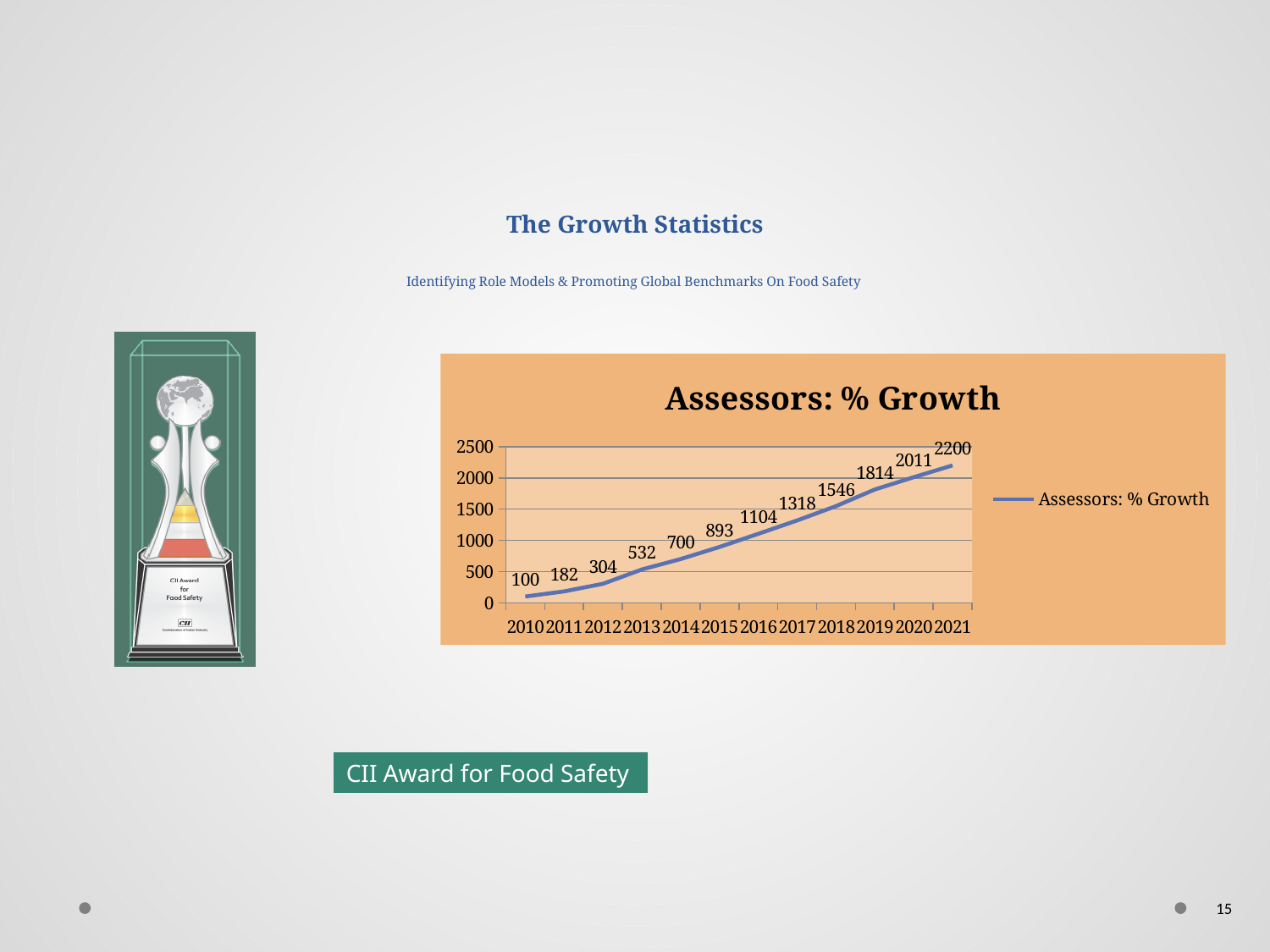
Which year has the highest value in the Assessors: % Growth chart? 2021 What kind of chart is the Assessors: % Growth chart? Line chart How many years are plotted in the Assessors: % Growth chart? 12 Is the value for 2017 in the Assessors: % Growth chart greater or less than 1000? greater Which is larger in the Assessors: % Growth chart, the value for 2013 or the value for 2016? 2016 What is the value for 2010 in the Assessors: % Growth chart? 100 Which year has the lowest value in the Assessors: % Growth chart? 2010 What is the value for 2015 in the Assessors: % Growth chart? 893 What is the difference between the values for 2021 and 2020 in the Assessors: % Growth chart? 189 What is the value for 2018 in the Assessors: % Growth chart? 1546 Do the values in the Assessors: % Growth chart rise or fall from 2010 to 2021? Rise What is the value for 2021 in the Assessors: % Growth chart? 2200